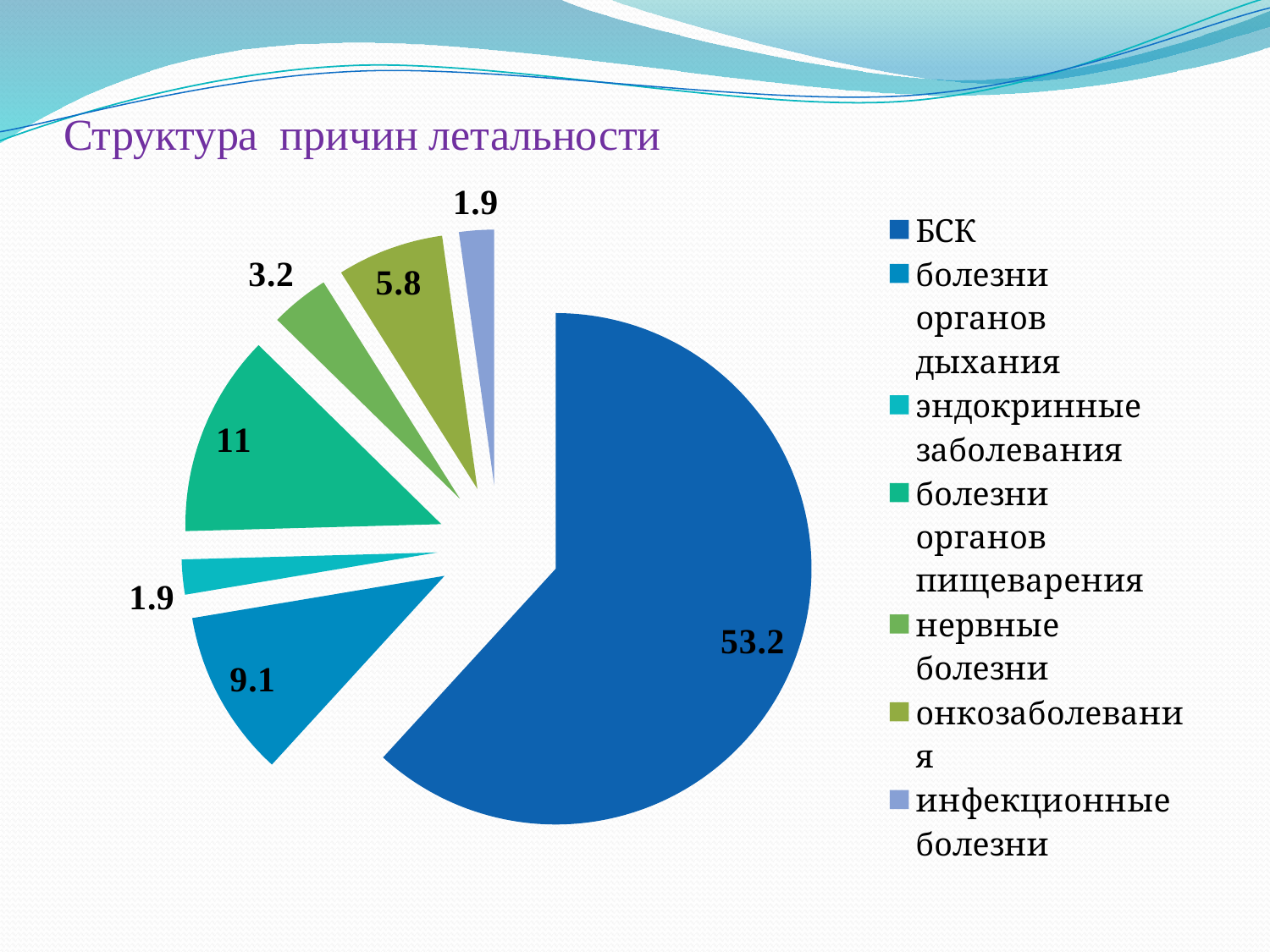
What is the value shown for болезни органов пищеварения? 11 What is the value shown for болезни органов дыхания? 9.1 What is the value shown for БСК? 53.2 Which category has the largest slice of the pie? БСК What type of chart is shown on the slide? pie chart What is the title of the slide? Структура причин летальности What is the value shown for нервные болезни? 3.2 How many categories does the legend list? 7 Which is larger, the value for болезни органов дыхания or the value for онкозаболевания? болезни органов дыхания What is the difference between the values for БСК and болезни органов пищеварения? 42.2 What is the value shown for онкозаболевания? 5.8 What is the value shown for инфекционные болезни? 1.9